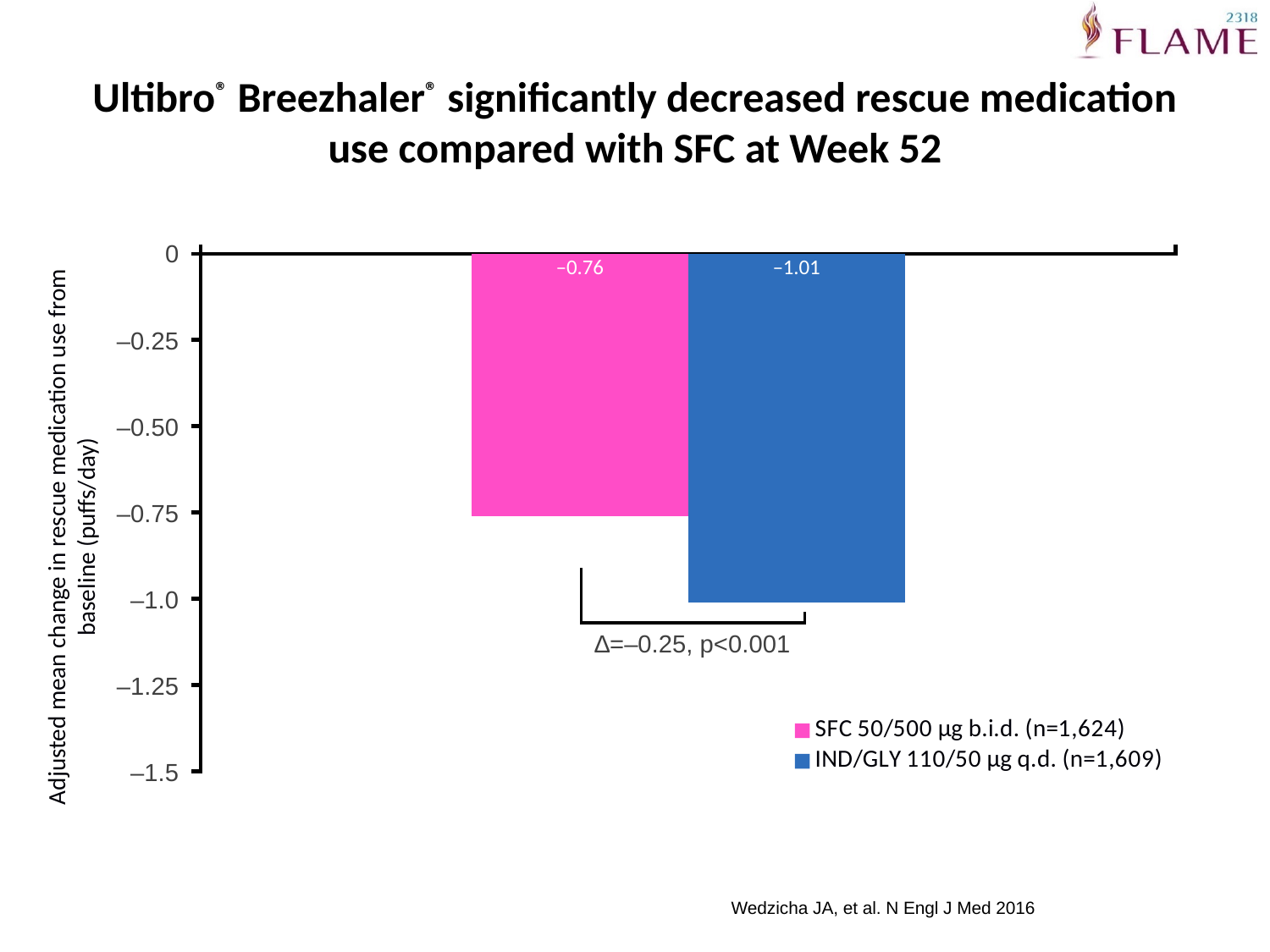
Is the value for IND/GLY 110/50 μg q.d. greater or less than –1.25? greater Which treatment shows the larger decrease in rescue medication use from baseline? IND/GLY 110/50 μg q.d. Is the value for IND/GLY 110/50 μg q.d. lower than the value for SFC 50/500 μg b.i.d.? Yes Which treatment shows the smaller decrease in rescue medication use from baseline? SFC 50/500 μg b.i.d. What is the adjusted mean change in rescue medication use from baseline for IND/GLY 110/50 μg q.d.? –1.01 What p-value is shown for the difference between the two treatments? p<0.001 What is the difference between the IND/GLY and SFC values shown on the chart? –0.25 What is the adjusted mean change in rescue medication use from baseline for SFC 50/500 μg b.i.d.? –0.76 What kind of chart is shown on the slide? Bar chart How many bars are plotted on the chart? 2 Is the value for SFC 50/500 μg b.i.d. greater or less than –0.50? less How many series does the legend list? 2